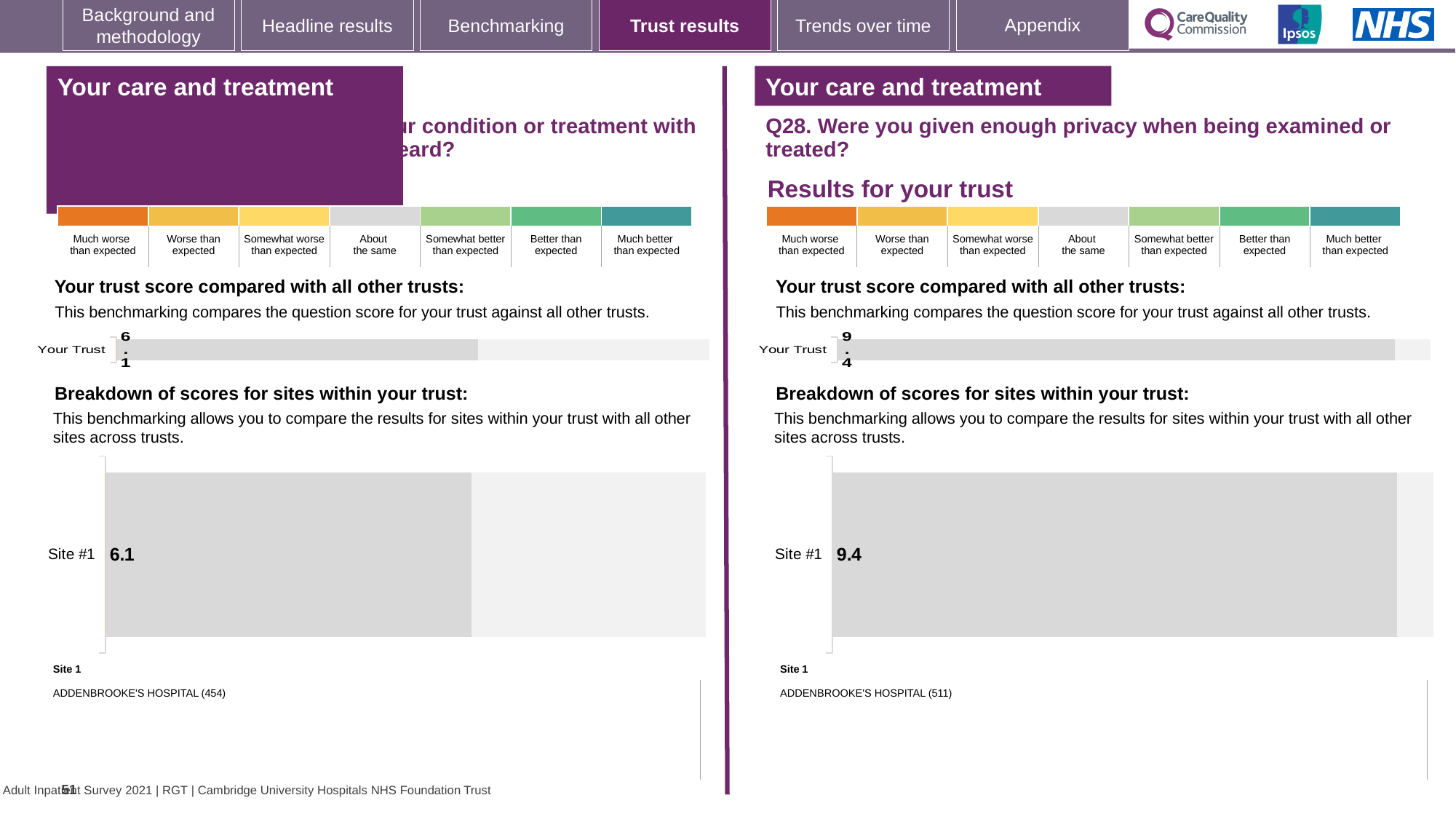
Which is larger: the Site #1 score on the left-hand site breakdown chart or the Site #1 score on the right-hand site breakdown chart for Q28? The right-hand (Q28) Site #1 score What is the difference between the Your Trust score on the right-hand Q28 chart and the Your Trust score on the left-hand chart? 3.3 What type of chart is used for the 'Your Trust' score on the right-hand Q28 section? Bar chart Which site is listed as Site 1 beneath the left-hand site breakdown chart? ADDENBROOKE'S HOSPITAL (454) What type of chart is used for the site breakdown on the left-hand section? Bar chart On the left-hand 'Your trust score compared with all other trusts' chart, what is the score shown for Your Trust? 6.1 Which site is listed as Site 1 beneath the right-hand Q28 site breakdown chart? ADDENBROOKE'S HOSPITAL (511) How many sites are shown in the right-hand 'Breakdown of scores for sites within your trust' chart for Q28? 1 On the right-hand chart for Q28 (privacy when being examined or treated), what is the score shown for Your Trust? 9.4 How many sites are shown in the left-hand 'Breakdown of scores for sites within your trust' chart? 1 On the left-hand 'Breakdown of scores for sites within your trust' chart, what is the score for Site #1? 6.1 On the right-hand 'Breakdown of scores for sites within your trust' chart for Q28, what is the score for Site #1? 9.4